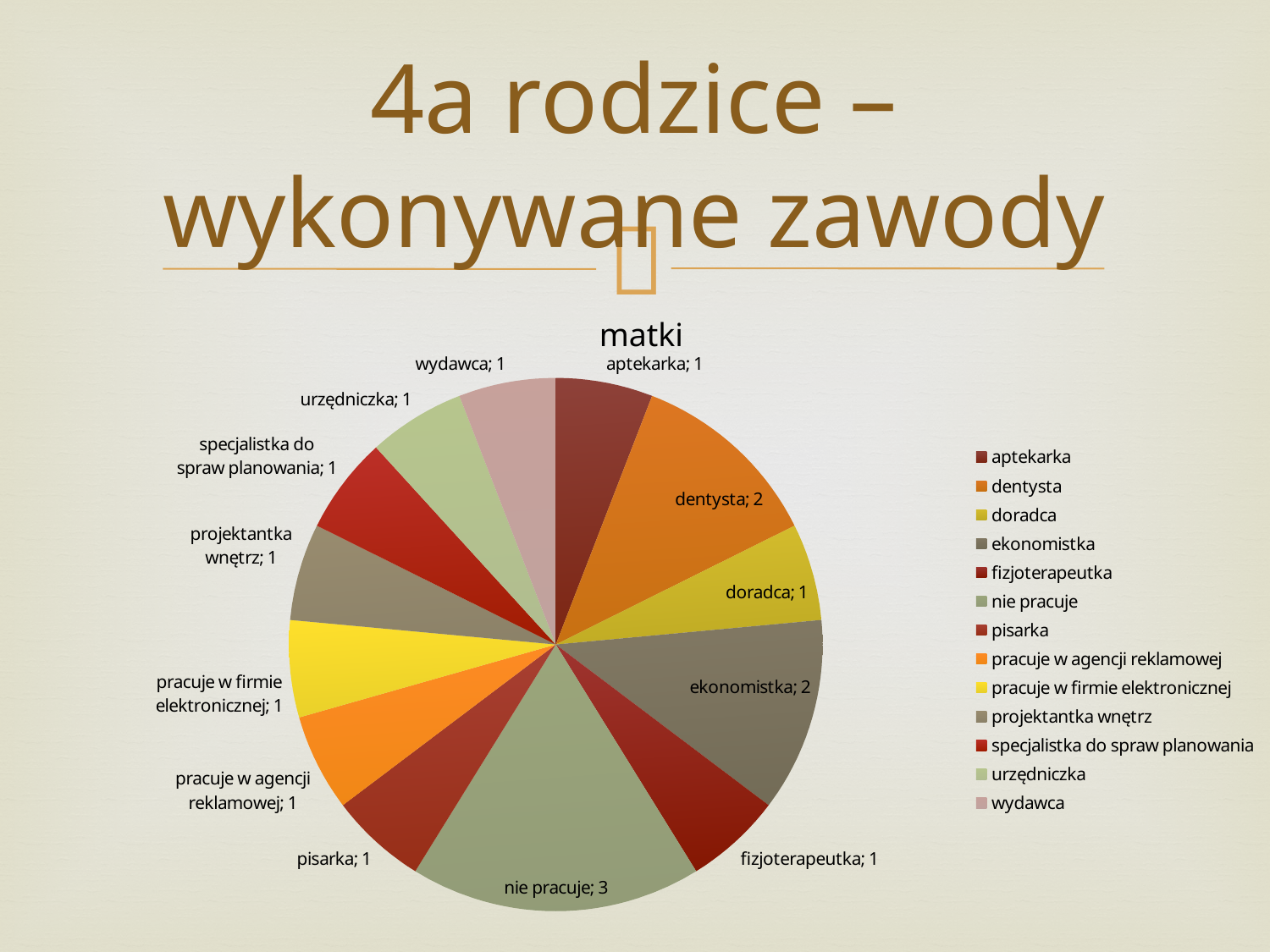
How many entries does the legend of the pie chart list? 13 Which category has the largest slice in the pie chart? nie pracuje What kind of chart is shown on the slide? pie chart What is the difference between the values for 'nie pracuje' and 'dentysta'? 1 What is the value for 'ekonomistka' in the pie chart? 2 How many categories (slices) does the pie chart have? 13 Which is larger in the pie chart, 'dentysta' or 'doradca'? dentysta What is the value for 'wydawca' in the pie chart? 1 What is the total of all the values shown in the pie chart? 17 What is the title of the pie chart? matki What is the value for 'dentysta' in the pie chart? 2 What is the value for 'nie pracuje' in the pie chart? 3